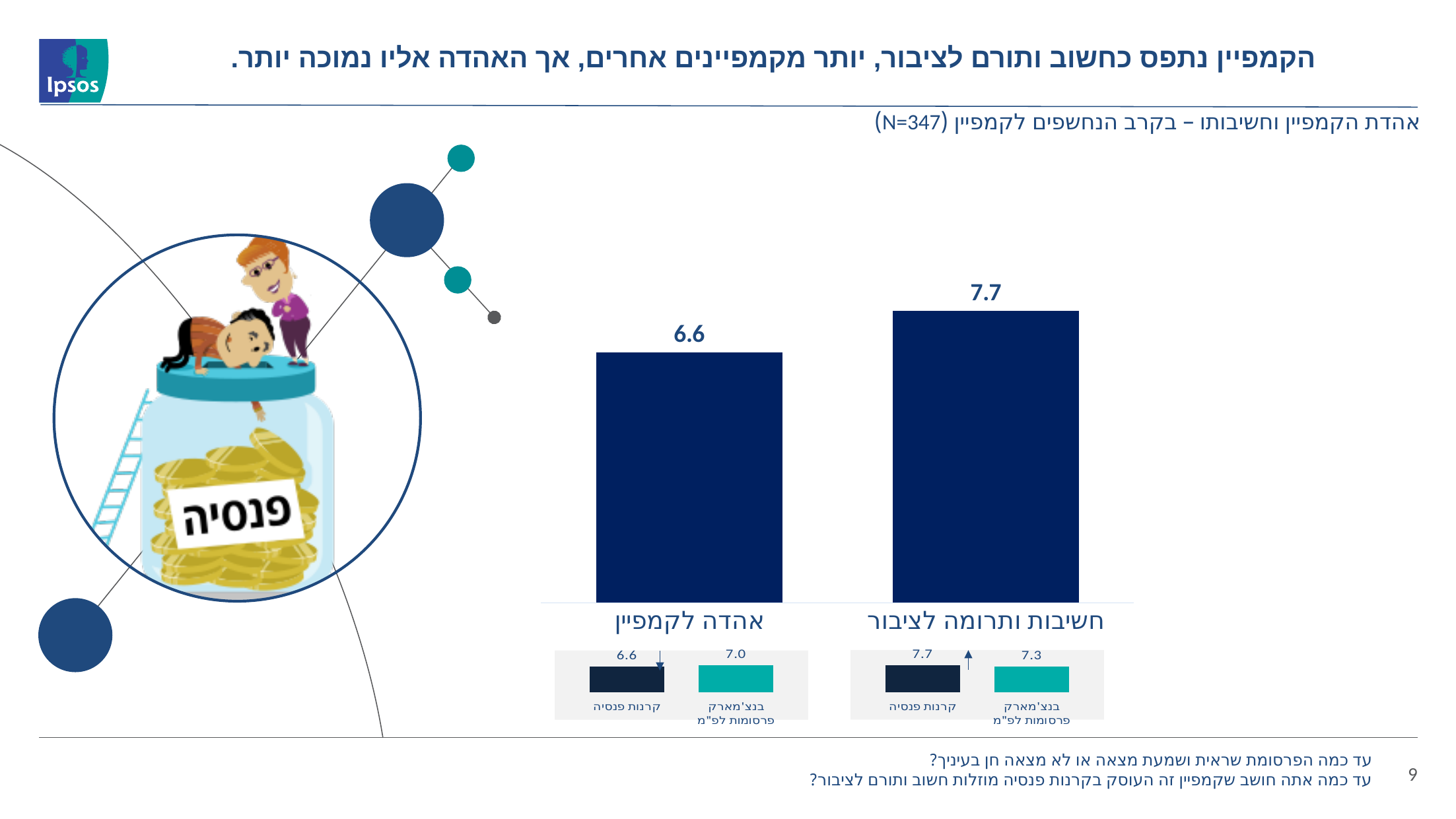
In the main bar chart, what is the value for אהדה לקמפיין? 6.6 In the main bar chart, how many bars are plotted? 2 What sample size (N) is stated in the main chart's subtitle? N=347 In the small comparison chart under אהדה לקמפיין, which is larger: קרנות פנסיה or בנצ'מארק פרסומות לפ"מ? בנצ'מארק פרסומות לפ"מ In the main bar chart, which category has the highest value? חשיבות ותרומה לציבור In the small comparison chart under חשיבות ותרומה לציבור, what is the difference between קרנות פנסיה and בנצ'מארק פרסומות לפ"מ? 0.4 In the small comparison chart under חשיבות ותרומה לציבור, what is the value for בנצ'מארק פרסומות לפ"מ? 7.3 What kind of chart is the main chart on the slide? bar chart In the main bar chart, what is the value for חשיבות ותרומה לציבור? 7.7 In the main bar chart, which category has the lowest value? אהדה לקמפיין In the small comparison chart under אהדה לקמפיין, what is the value for בנצ'מארק פרסומות לפ"מ? 7.0 In the main bar chart, what is the difference between the values for חשיבות ותרומה לציבור and אהדה לקמפיין? 1.1